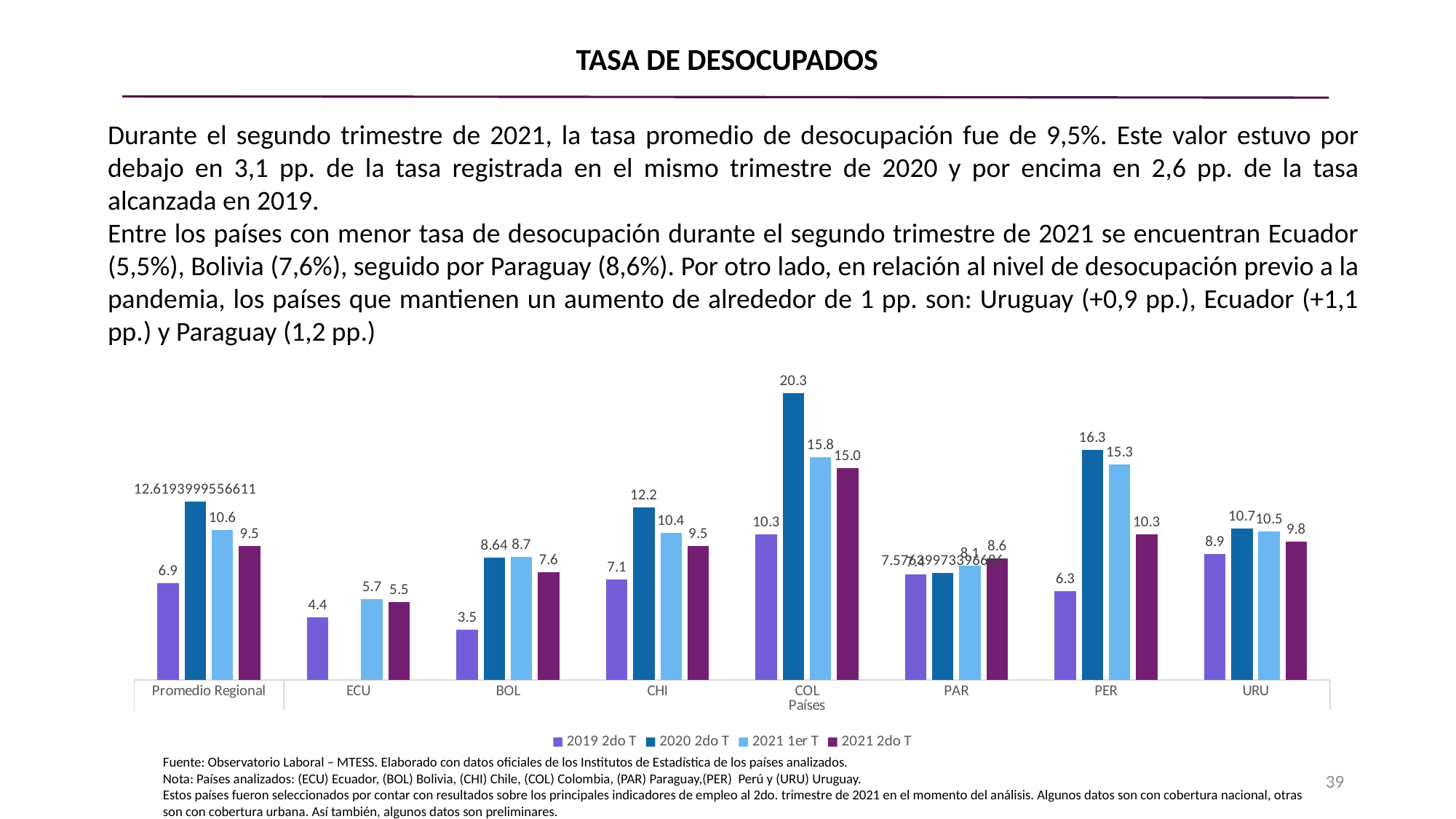
How many series does the legend list? 4 Which is larger for CHI: the 2021 1er T value or the 2021 2do T value? 2021 1er T What is the difference between the 2020 2do T and 2021 2do T values for PER? 6.0 Which category has the lowest value in the 2021 2do T series? ECU How many categories are shown on the x axis? 8 What is the value for BOL in the 2019 2do T series? 3.5 Which category has the highest value in the 2020 2do T series? COL What is the value for PER in the 2021 1er T series? 15.3 Which series is shown in the darkest purple colour in the legend? 2021 2do T What is the value for ECU in the 2021 2do T series? 5.5 What is the value for COL in the 2020 2do T series? 20.3 What type of chart is shown on the slide? bar chart